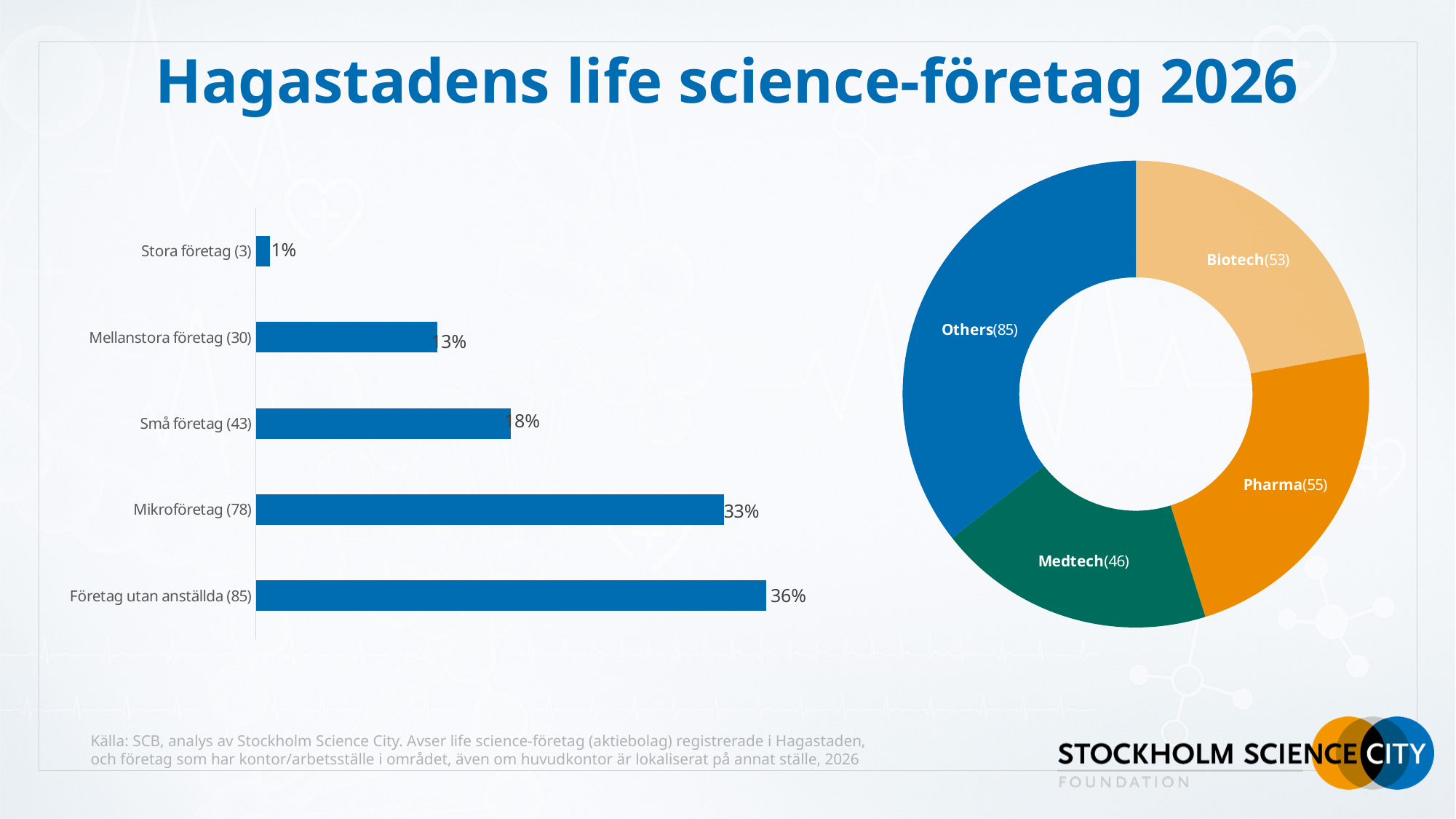
In the donut chart on the right, how many companies are in the Medtech segment? 46 How many categories does the bar chart on the left show? 5 In the bar chart on the left, which is larger: the percentage for Mellanstora företag (30) or for Små företag (43)? Små företag (43) In the bar chart on the left, what percentage is shown for Små företag (43)? 18% In the bar chart on the left, what percentage is shown for Mikroföretag (78)? 33% In the bar chart on the left, which category has the highest percentage? Företag utan anställda (85) In the bar chart on the left, which category has the lowest percentage? Stora företag (3) How many segments does the donut chart on the right have? 4 In the donut chart on the right, what is the difference between the Pharma and Biotech counts? 2 What kind of chart is shown on the left of the slide? Bar chart In the bar chart on the left, what is the difference in percentage points between Företag utan anställda (85) and Mikroföretag (78)? 3 In the donut chart on the right, which segment has the largest number of companies? Others (85)